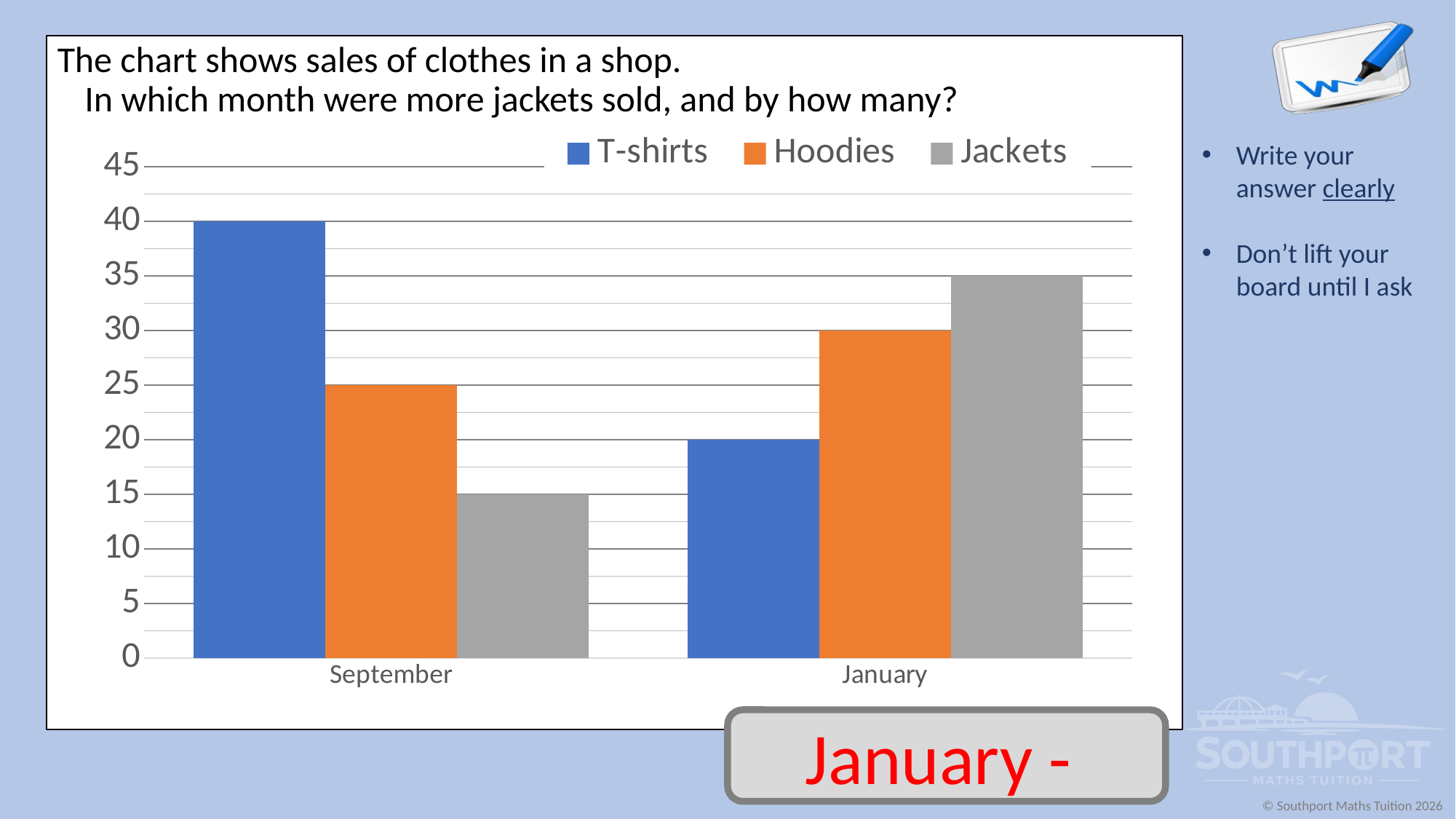
Which colour represents Hoodies in the legend? orange Do T-shirt sales rise or fall from September to January? fall What kind of chart is shown on the slide? bar chart What is the value for Jackets in January? 35 What is the difference between Jackets sales in January and in September? 20 Which item has the lowest sales in September? Jackets What is the value for T-shirts in September? 40 Which is larger, Hoodies in January or Hoodies in September? Hoodies in January Which item has the highest sales in January? Jackets What is the value for Hoodies in September? 25 How many months are shown on the x axis? 2 How many series does the legend list? 3